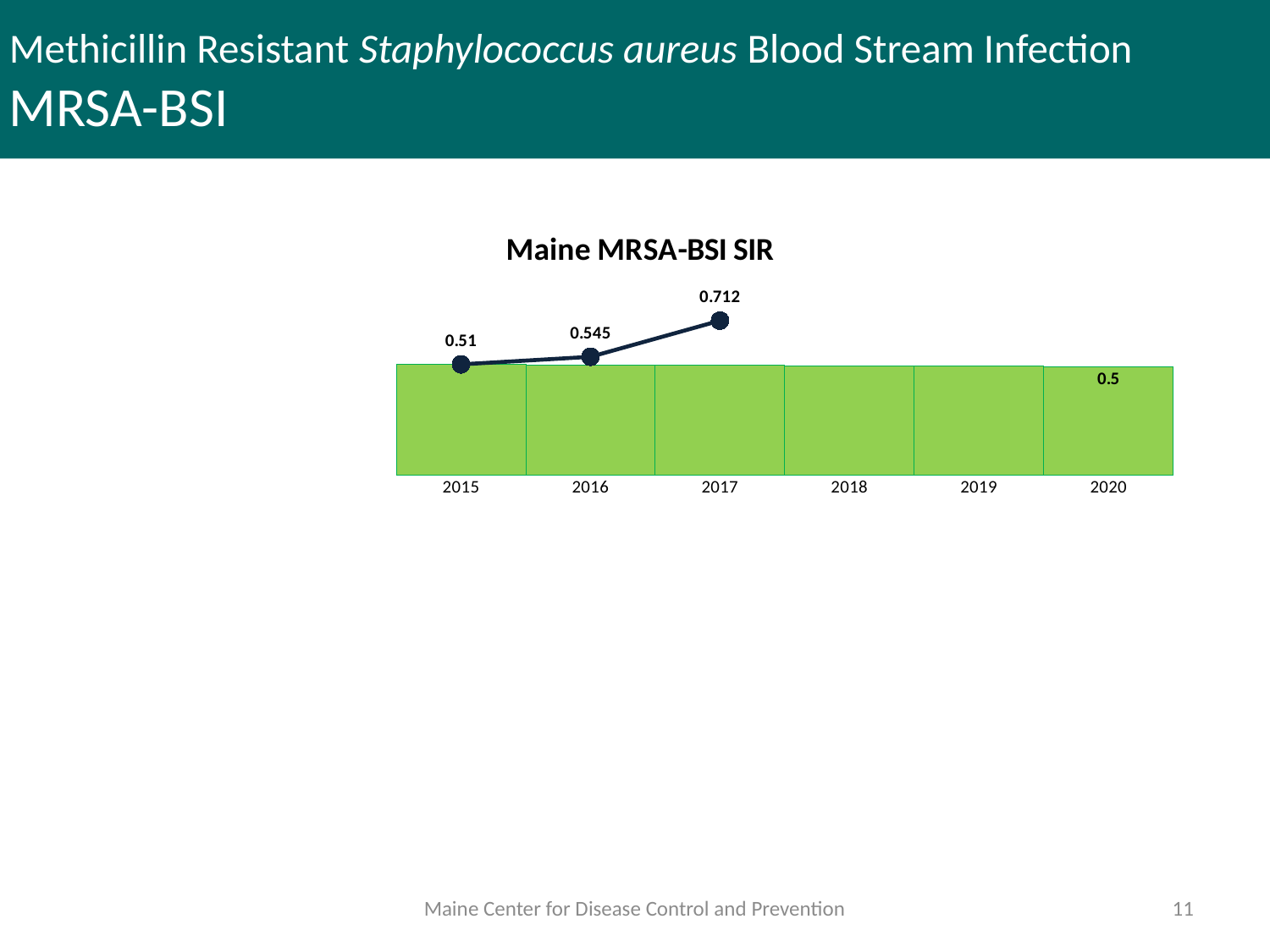
Which year has the highest SIR value on the line? 2017 What is the difference between the SIR values for 2017 and 2016? 0.167 What is the Maine MRSA-BSI SIR value for 2016? 0.545 How many years are shown on the x axis? 6 What is the Maine MRSA-BSI SIR value for 2015? 0.51 What is the Maine MRSA-BSI SIR value for 2017? 0.712 Which year has a larger SIR value, 2015 or 2017? 2017 Does the SIR line rise or fall from 2015 to 2017? rise What is the difference between the SIR values for 2016 and 2015? 0.035 What value is labelled on the green bar for 2020? 0.5 What is the title of the chart? Maine MRSA-BSI SIR Which year has the lowest SIR value on the line? 2015